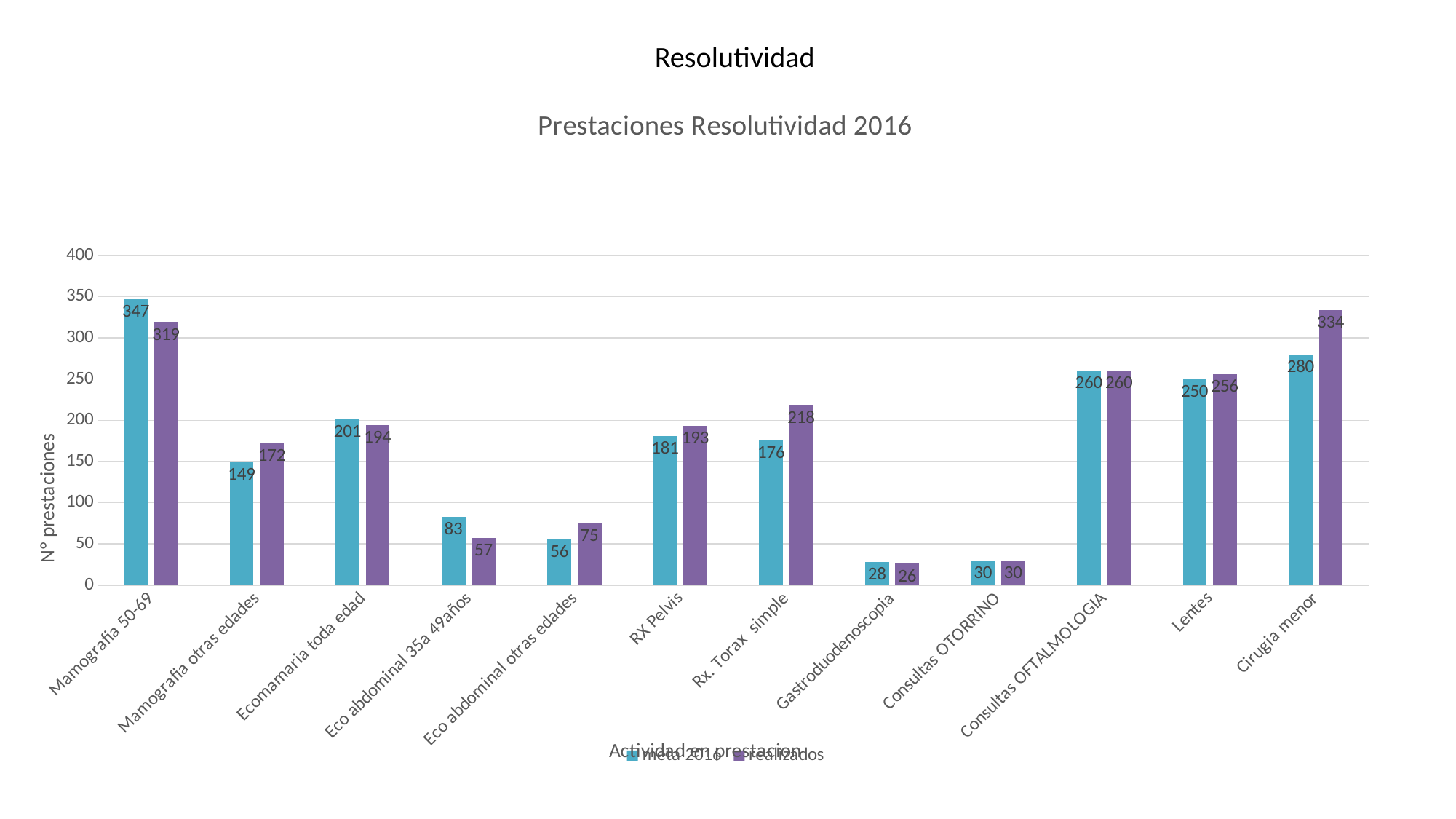
Is the realizados value for Mamografia 50-69 greater or less than 300? greater How many categories are shown on the x axis? 12 What kind of chart is shown? bar chart Which category has the highest meta 2016 value? Mamografia 50-69 What is the meta 2016 value for Mamografia 50-69? 347 What is the realizados value for Rx. Torax simple? 218 How many series does the legend list? 2 Which category has the lowest realizados value? Gastroduodenoscopia Which is larger for Eco abdominal 35a 49años: meta 2016 or realizados? meta 2016 What is the difference between the meta 2016 and realizados values for Cirugia menor? 54 What is the title of the chart? Prestaciones Resolutividad 2016 What is the realizados value for Cirugia menor? 334